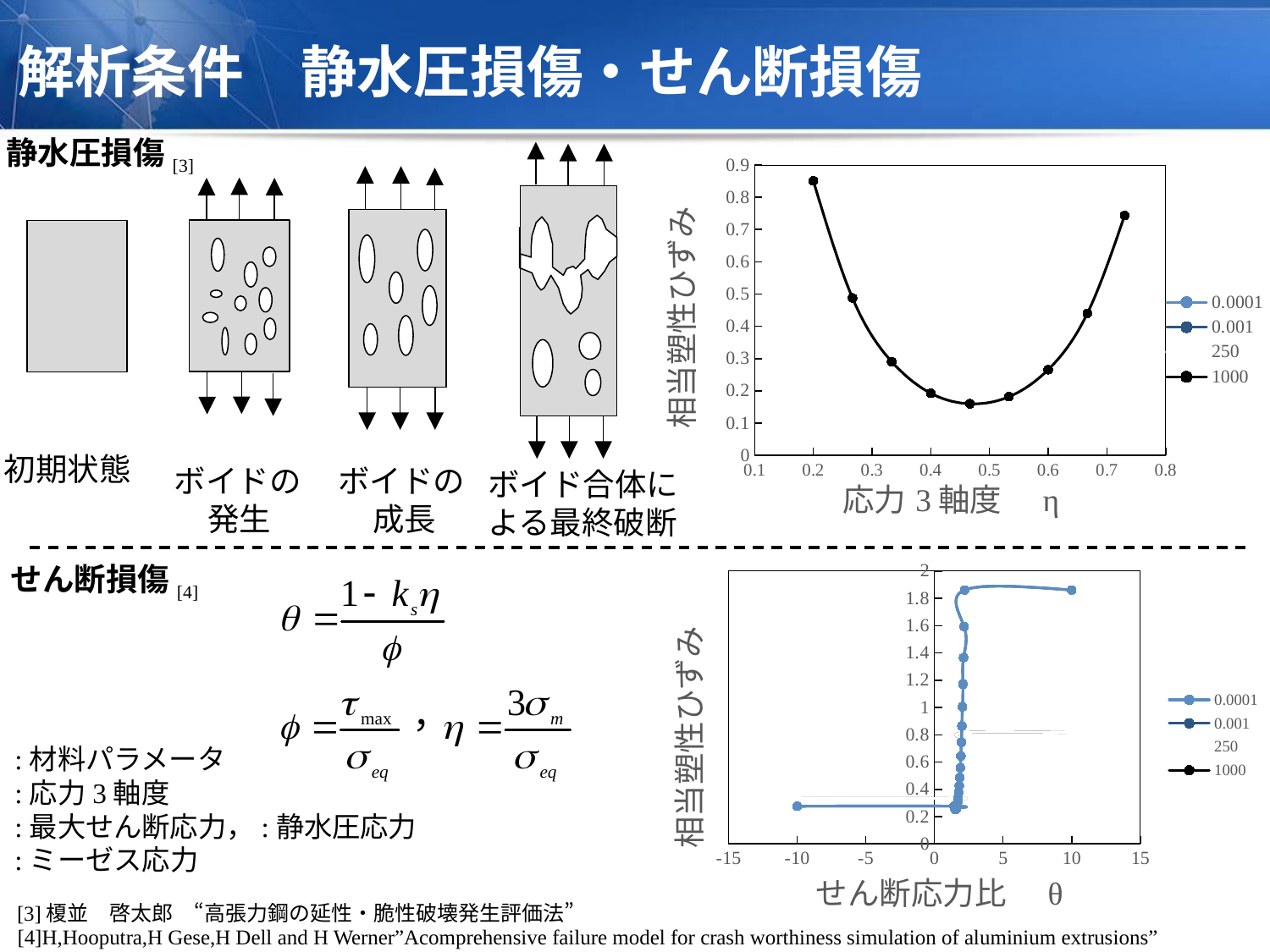
What kind of chart is the top-right chart (相当塑性ひずみ vs 応力3軸度 η)? line chart How many series does the legend of the top-right chart list? 4 In the top-right chart, which is larger: the value at η = 0.2 or the value at η = 0.73? η = 0.2 In the top-right chart, is the value at η = 0.6 greater or less than 0.4? less In the top-right chart, is the value at η = 0.2 greater or less than 0.8? greater In the top-right chart, is the lowest point of the curve greater or less than 0.2? less In the top-right chart, do the values rise or fall as η increases from 0.2 to about 0.47? fall What entries appear in the legend of the top-right chart? 0.0001, 0.001, 250, 1000 What is the x-axis label of the bottom-right chart? せん断応力比 θ How many data points are plotted on the curve in the top-right chart? 9 What kind of chart is the bottom-right chart (相当塑性ひずみ vs せん断応力比 θ)? line chart In the top-right chart, do the values rise or fall as η increases from about 0.47 to 0.73? rise